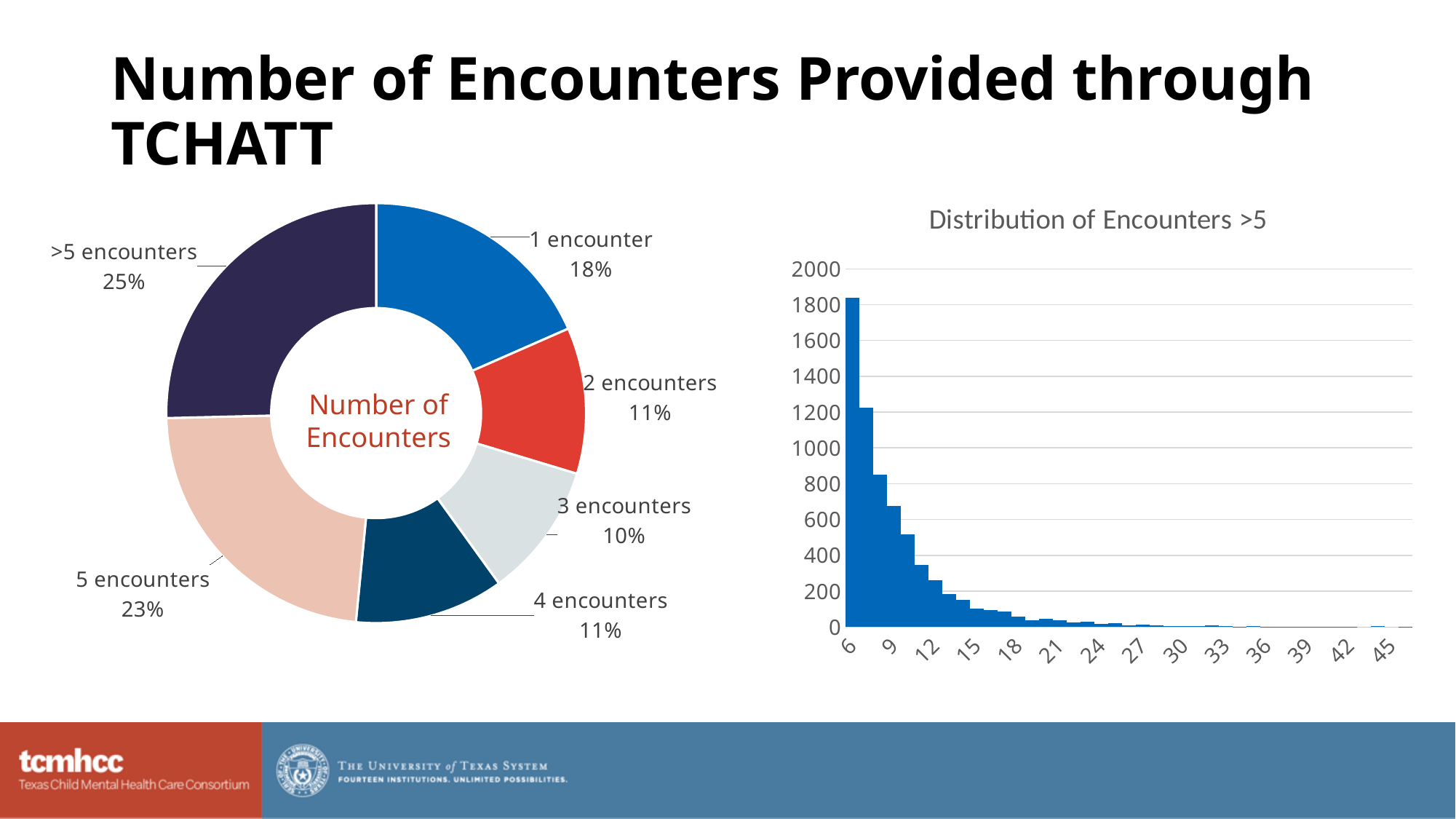
In the donut chart titled Number of Encounters, what share is labelled for 3 encounters? 10% In the chart titled Distribution of Encounters >5, do the values rise or fall as the number of encounters increases along the x axis? fall In the chart titled Distribution of Encounters >5, is the value for 6 greater or less than 1600? greater What kind of chart is the chart titled Distribution of Encounters >5? bar chart In the donut chart titled Number of Encounters, what share is labelled for 1 encounter? 18% In the donut chart titled Number of Encounters, which category has the largest share? >5 encounters How many categories does the donut chart titled Number of Encounters show? 6 In the donut chart titled Number of Encounters, what is the difference in percentage points between >5 encounters and 1 encounter? 7 In the chart titled Distribution of Encounters >5, is the value for 9 greater or less than 800? less In the donut chart titled Number of Encounters, which category has the smallest share? 3 encounters In the donut chart titled Number of Encounters, what share is labelled for 5 encounters? 23% In the donut chart titled Number of Encounters, which is larger: the share for 5 encounters or the share for 2 encounters? 5 encounters